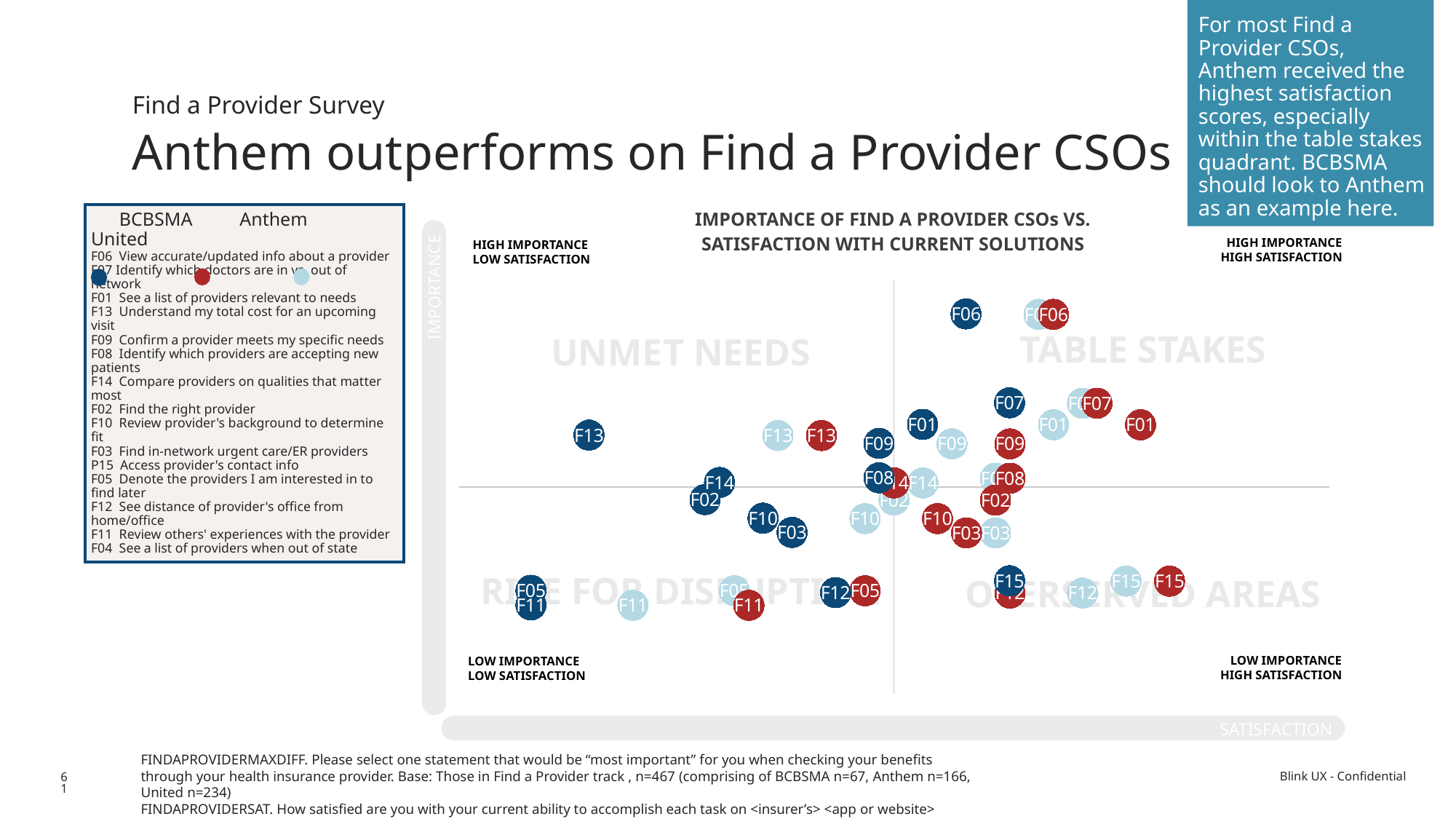
For BCBSMA, which CSO has higher importance, F06 or F11? F06 What kind of chart is shown on the slide? Scatter chart How many Find a Provider CSOs are listed in the legend box? 15 What is the title of the chart? Importance of Find a Provider CSOs vs. Satisfaction with Current Solutions How many series (insurers) does the legend list? 3 Which CSO has the highest importance across all three insurers? F06 For F13, which insurer has higher satisfaction, BCBSMA or Anthem? Anthem Which quadrant does BCBSMA's F11 point fall in? Ripe for Disruption What does the horizontal axis of the chart represent? Satisfaction Which quadrant does Anthem's F06 point fall in? Table Stakes Which quadrant does Anthem's F15 point fall in? Underserved Areas Which quadrant does BCBSMA's F13 point fall in? Unmet Needs